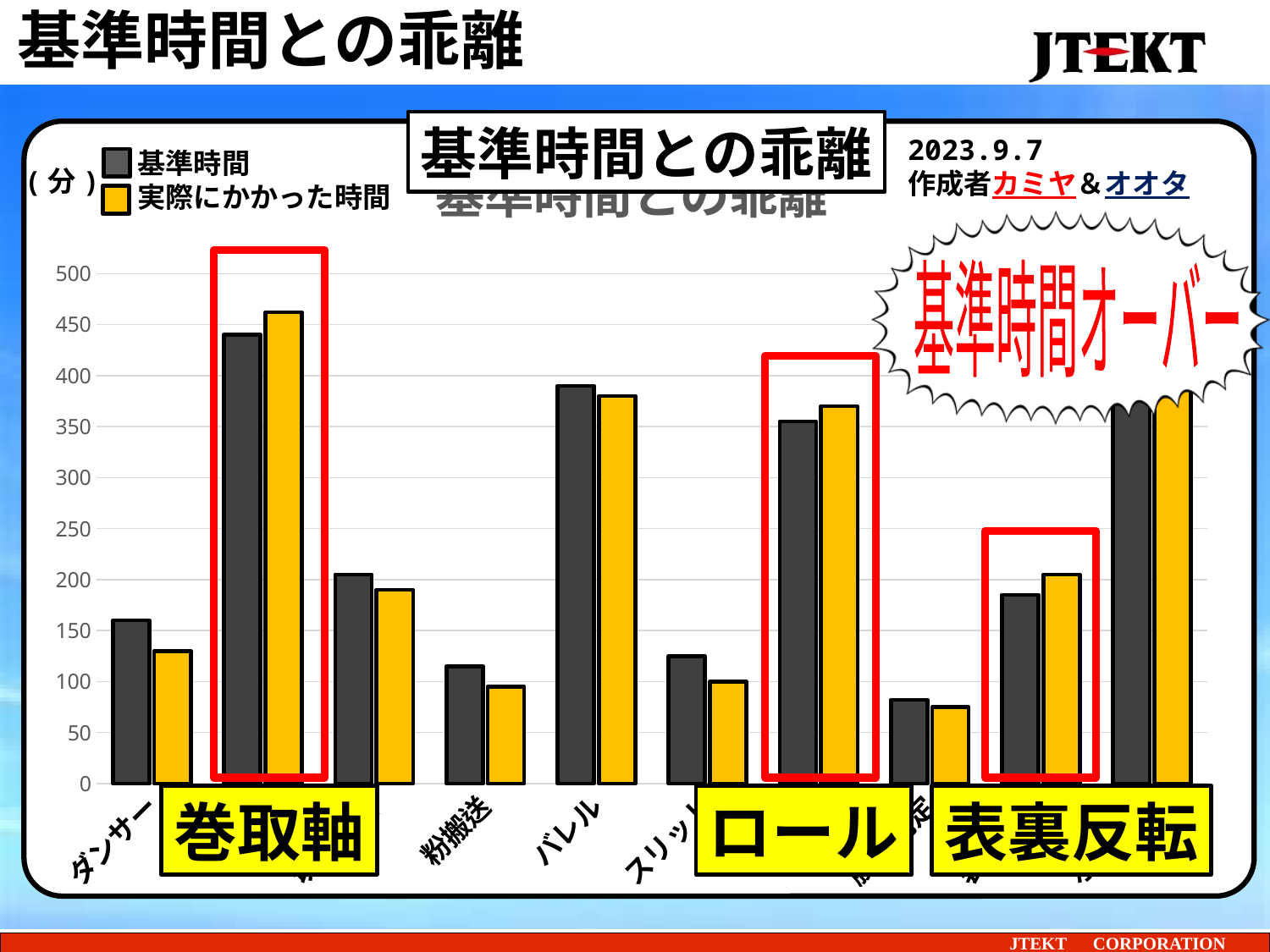
How many series does the chart legend list? 2 Is the 実際にかかった時間 value for ロール greater or less than 300? greater For 巻取軸, which is larger: 基準時間 or 実際にかかった時間? 実際にかかった時間 What kind of chart is shown on the slide? bar chart Is the 基準時間 value for ダンサー greater or less than 100? greater For ダンサー, which is larger: 基準時間 or 実際にかかった時間? 基準時間 Is the 基準時間 value for 表裏反転 greater or less than 250? less Which category has the highest 基準時間 value? 巻取軸 What unit is shown for the chart's vertical axis? 分 What are the two series named in the chart legend? 基準時間 and 実際にかかった時間